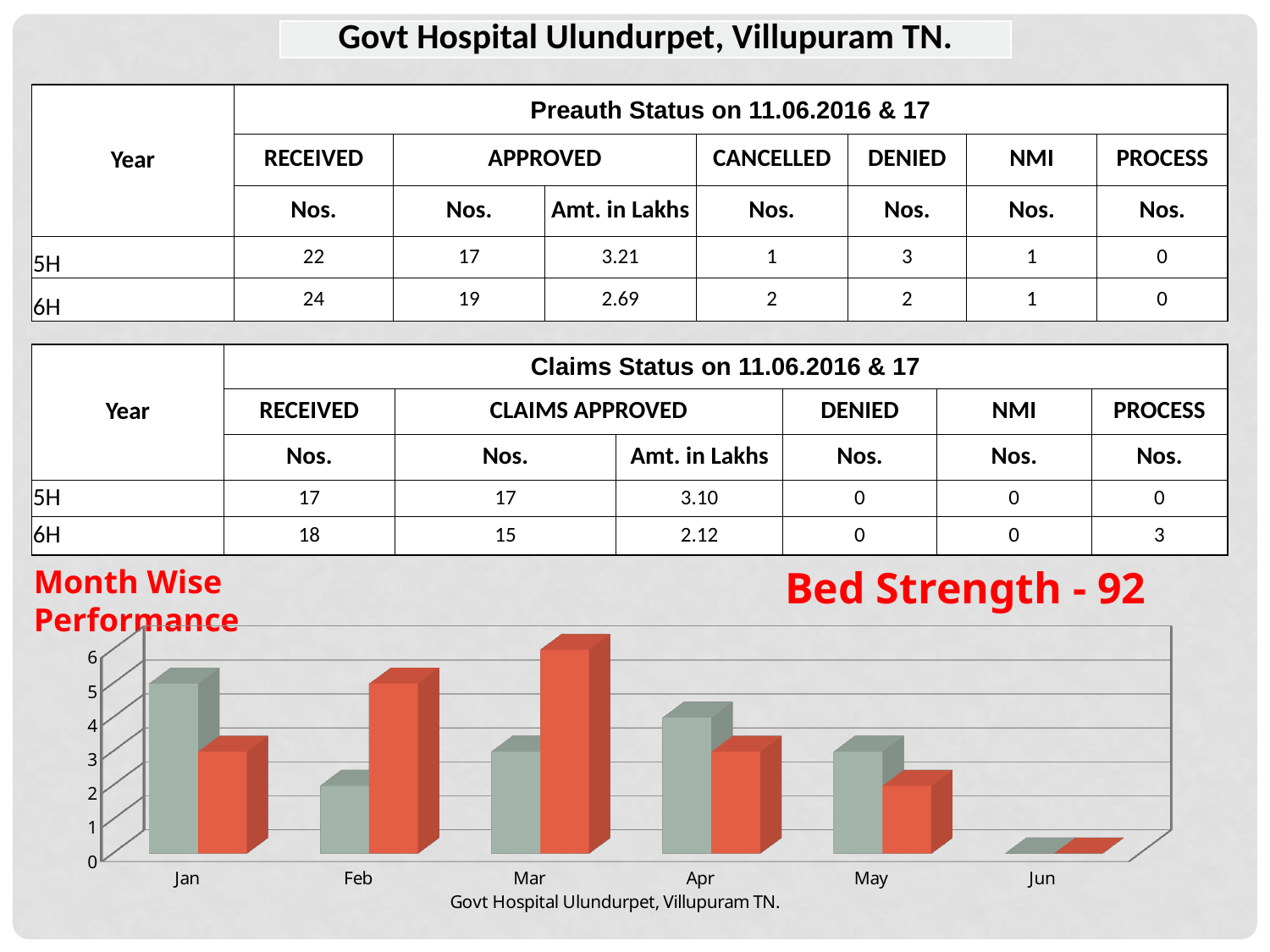
In the bar chart, for Jan, which bar is taller: the grey bar or the orange bar? grey bar In the bar chart, which month has the tallest grey bar? Jan In the bar chart, is the orange bar for May greater or less than 3? less How many months are shown on the x axis of the bar chart? 6 In the bar chart, is the grey bar for Jan greater or less than 4? greater What kind of chart is shown at the bottom of the slide? bar chart In the bar chart, is the grey bar for Feb greater or less than 3? less In the bar chart, for Feb, which bar is taller: the grey bar or the orange bar? orange bar In the bar chart, which month has the tallest orange bar? Mar What text appears below the x axis of the bar chart? Govt Hospital Ulundurpet, Villupuram TN. In the bar chart, which month has the lowest bars overall? Jun